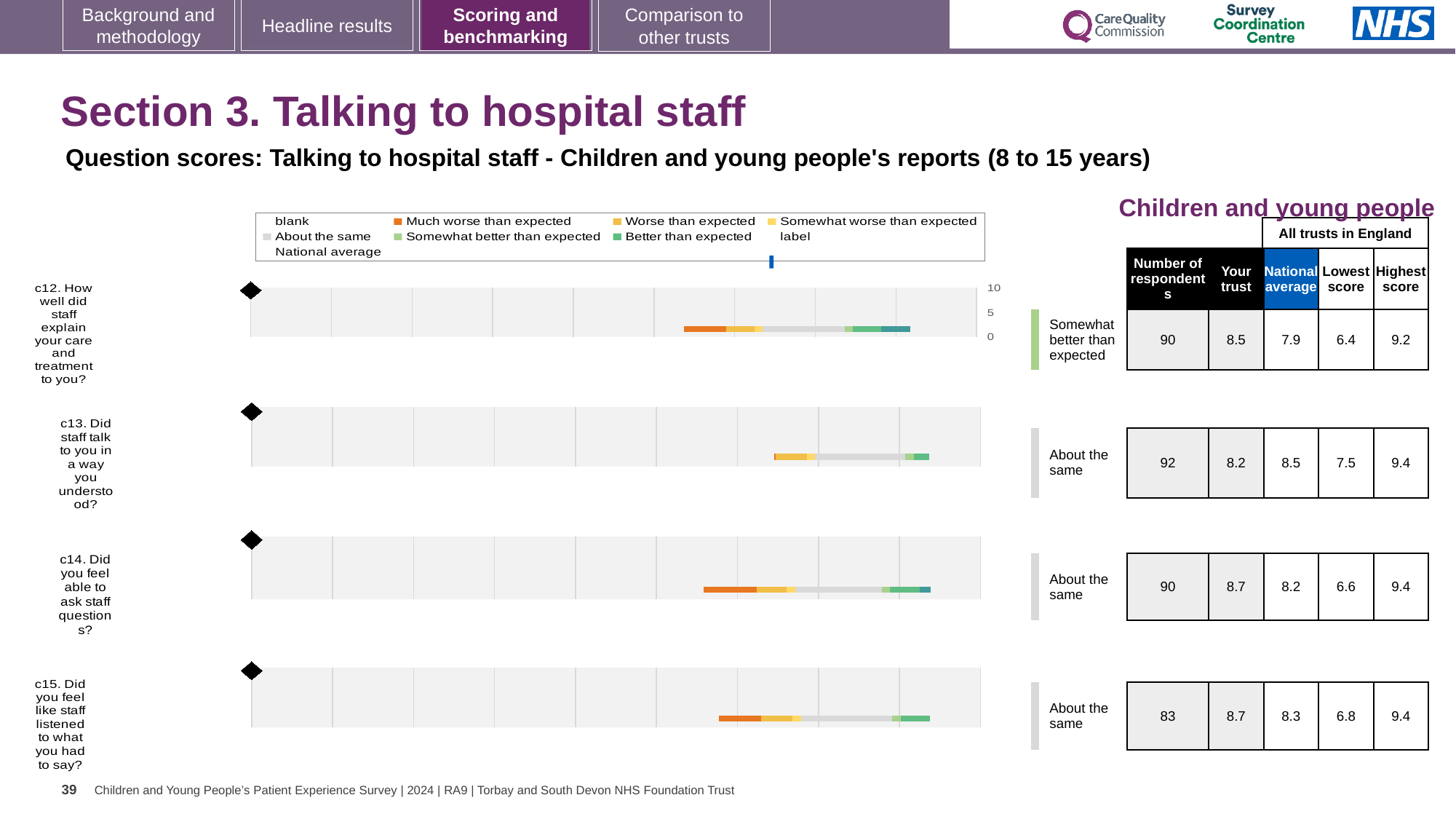
What is the highest score across all trusts in England for question c12? 9.2 Which benchmarking category is shown for question c12? Somewhat better than expected What kind of chart is used to show the benchmarking bands for each question? bar chart For question c14, which is larger: the 'Your trust' score or the national average? Your trust How many respondents answered question c15 (Did you feel like staff listened to what you had to say?)? 83 What is the national average score for question c13 (Did staff talk to you in a way you understood?)? 8.5 What is the difference between the 'Your trust' score and the national average for question c12? 0.6 How many survey questions are plotted as charts on this slide? 4 Which question has the lowest 'Your trust' score? c13 Which question has the lowest national average score? c12 Which question has the highest number of respondents? c13 What is the 'Your trust' score for question c12 (How well did staff explain your care and treatment to you?)? 8.5